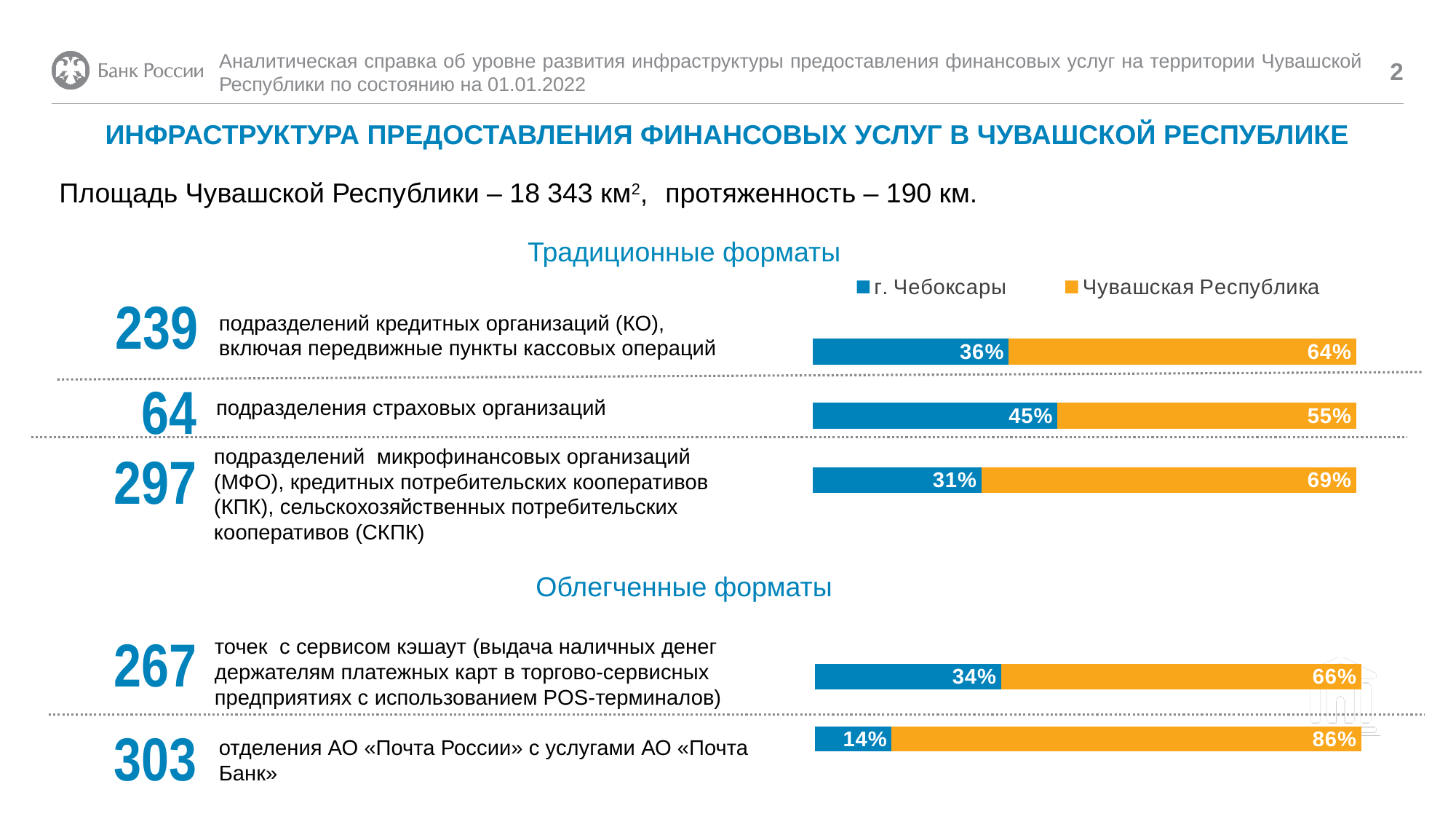
In the 'Традиционные форматы' chart, what share of подразделения кредитных организаций (КО) is in Чувашская Республика? 64% In the 'Традиционные форматы' chart, which category has the lowest share for г. Чебоксары? подразделений микрофинансовых организаций (МФО), КПК, СКПК In the 'Облегченные форматы' chart, what share of отделения АО «Почта России» is in г. Чебоксары? 14% In the 'Традиционные форматы' chart, what share of подразделения страховых организаций is in г. Чебоксары? 45% What type of chart is used for 'Облегченные форматы'? Stacked bar chart How many series does the legend of the 'Традиционные форматы' chart list? 2 In the 'Традиционные форматы' chart, which category has the highest share for г. Чебоксары? подразделения страховых организаций How many categories (bars) are shown in the 'Традиционные форматы' chart? 3 In the 'Облегченные форматы' chart, what is the difference between the Чувашская Республика share and the г. Чебоксары share for отделения АО «Почта России»? 72% In the 'Традиционные форматы' chart, which colour represents Чувашская Республика? Orange In the 'Традиционные форматы' chart, which is larger for подразделения страховых организаций: the г. Чебоксары share or the Чувашская Республика share? Чувашская Республика In the 'Облегченные форматы' chart, what share of точки с сервисом кэшаут is in Чувашская Республика? 66%